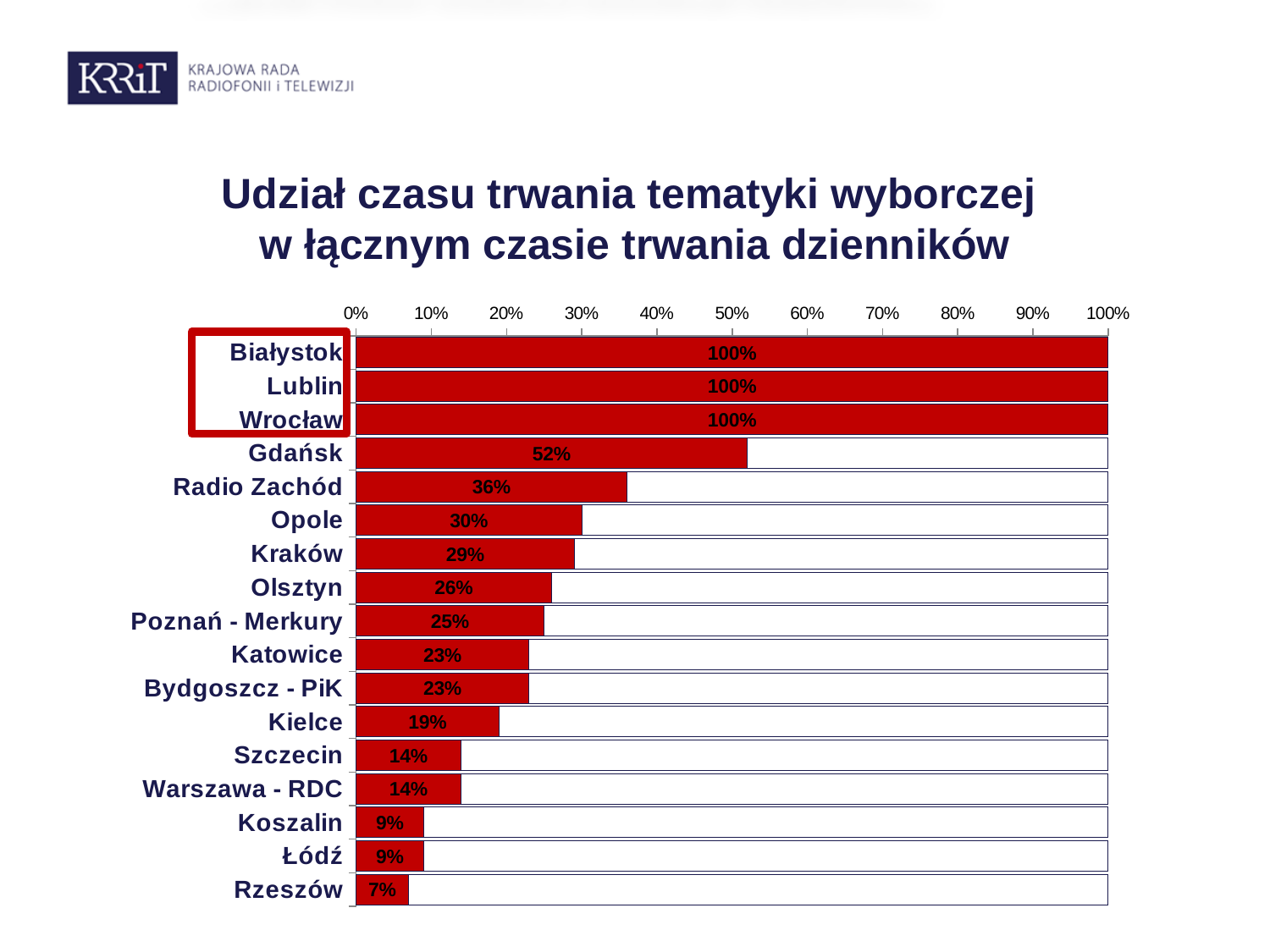
Which is larger, the value for Olsztyn or the value for Szczecin? Olsztyn What is the value for Radio Zachód? 36% What is the value for Gdańsk? 52% What kind of chart is shown on the slide? Bar chart What is the value for Kielce? 19% What is the value for Poznań - Merkury? 25% What is the difference between the values for Gdańsk and Opole? 22% What is the difference between the values for Kraków and Rzeszów? 22% How many categories are shown in the chart? 17 What is the title of the chart? Udział czasu trwania tematyki wyborczej w łącznym czasie trwania dzienników How many categories have a value of 100%? 3 Which category has the lowest value? Rzeszów